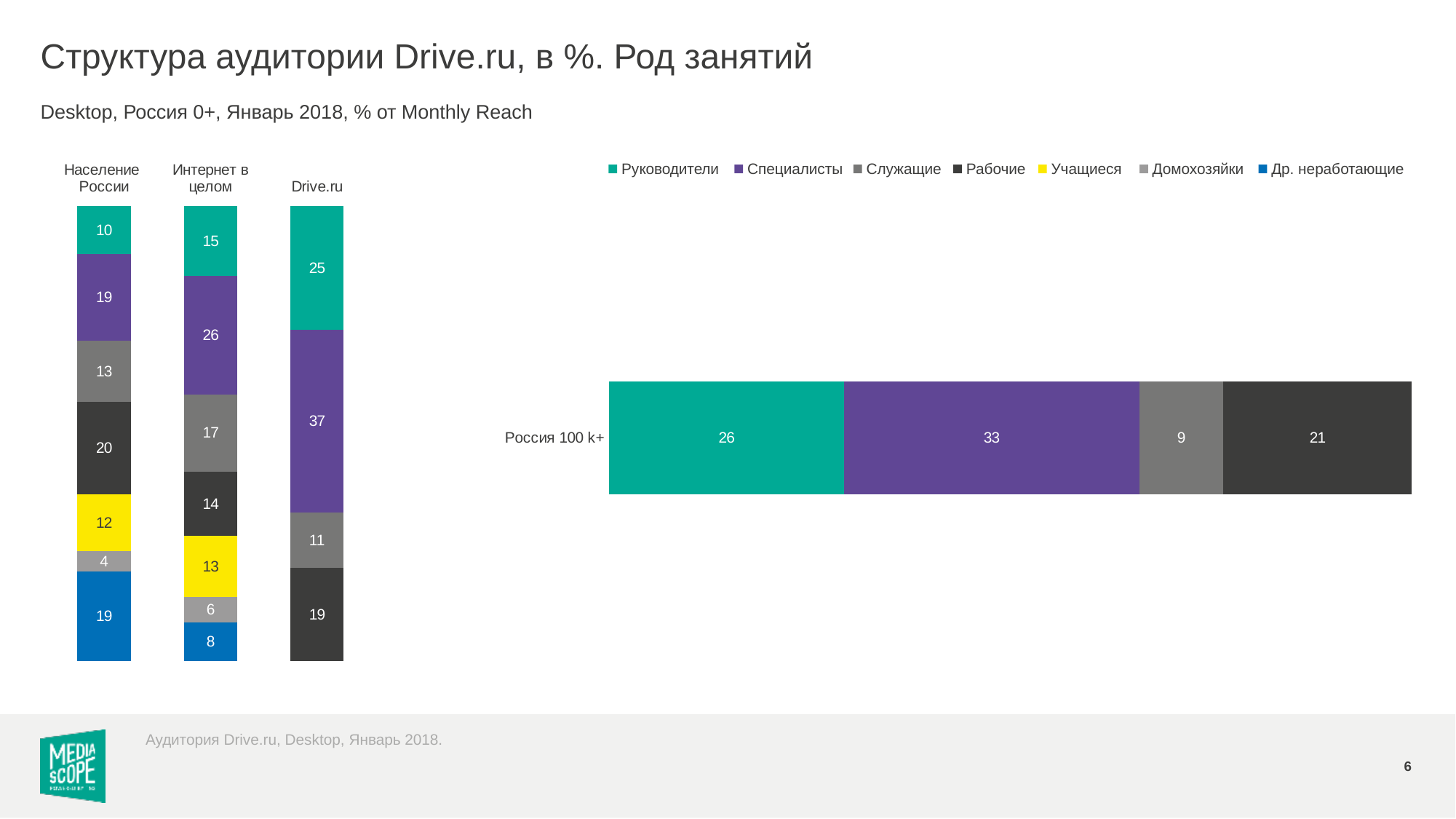
How many series does the legend list? 7 In the left chart, what is the difference between the Специалисты values for Drive.ru and Интернет в целом? 11 In the left chart, what is the value for Рабочие in the Население России bar? 20 In the left chart, which is larger: Руководители for Drive.ru or Руководители for Интернет в целом? Drive.ru In the right chart (Россия 100 k+), what is the value for Руководители? 26 In the left chart, what is the value for Учащиеся in the Интернет в целом bar? 13 In the right chart (Россия 100 k+), which segment has the highest value? Специалисты In the left chart, which segment of the Население России bar has the lowest value? Домохозяйки In the left chart, what is the value for Специалисты in the Drive.ru bar? 37 What kind of chart is the right chart (Россия 100 k+)? Stacked bar chart How many bars does the left chart have? 3 In the right chart (Россия 100 k+), what is the total of the four segments? 89